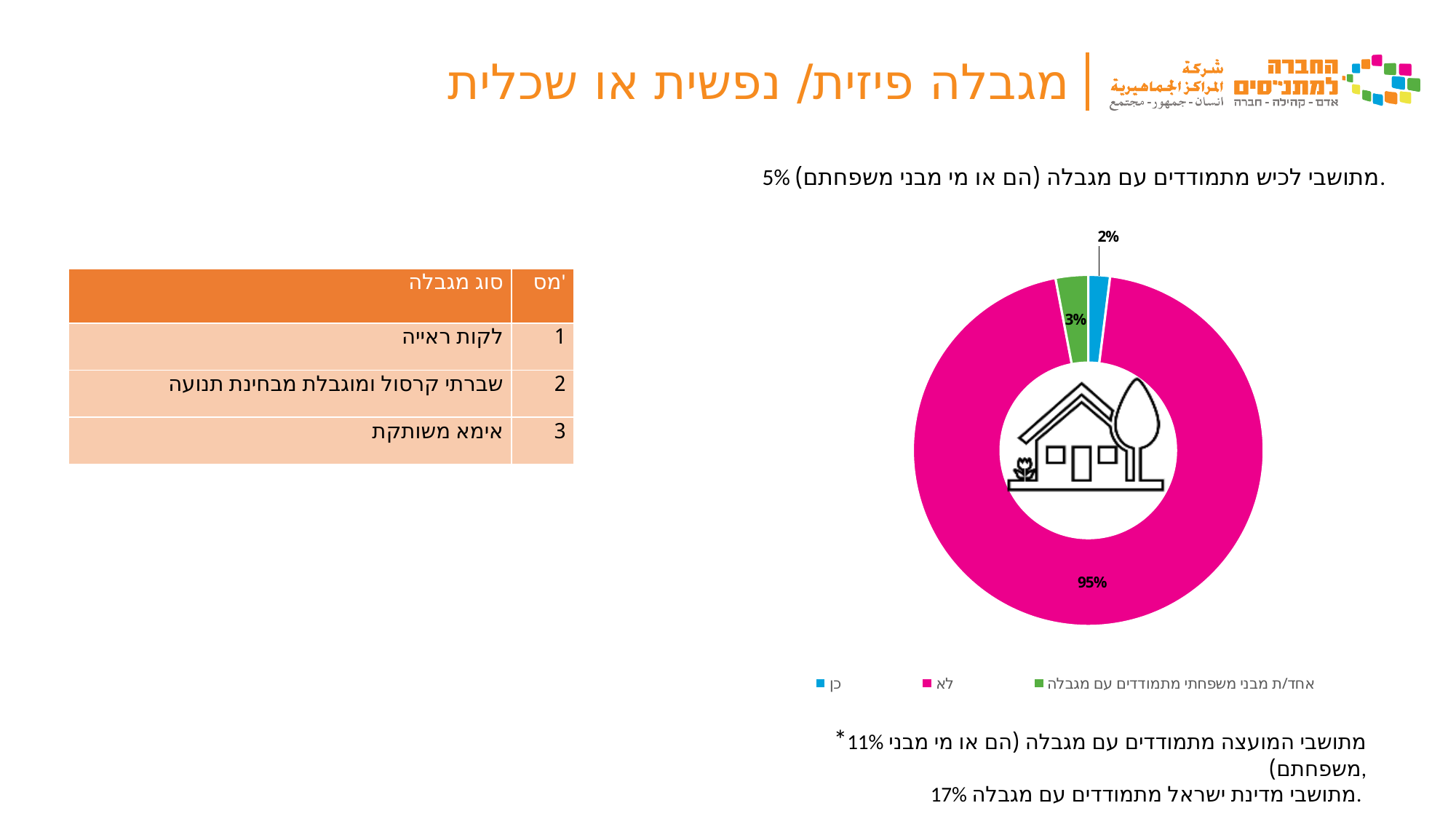
Which category has the smallest slice in the pie chart? כן Which category has the largest slice in the pie chart? לא What colour is the "לא" slice in the pie chart? Pink What percentage is shown for the "כן" slice of the pie chart? 2% How many entries does the legend of the pie chart list? 3 What kind of chart is shown on the slide? Pie chart (donut) What is the difference in percentage points between the "לא" slice and the "כן" slice? 93 What percentage is shown for the "לא" slice of the pie chart? 95% What percentage is shown for the "אחד/ת מבני משפחתי מתמודדים עם מגבלה" slice of the pie chart? 3% Which slice is larger: "אחד/ת מבני משפחתי מתמודדים עם מגבלה" or "כן"? אחד/ת מבני משפחתי מתמודדים עם מגבלה How many slices does the pie chart have? 3 What colour is the "כן" slice in the pie chart? Blue